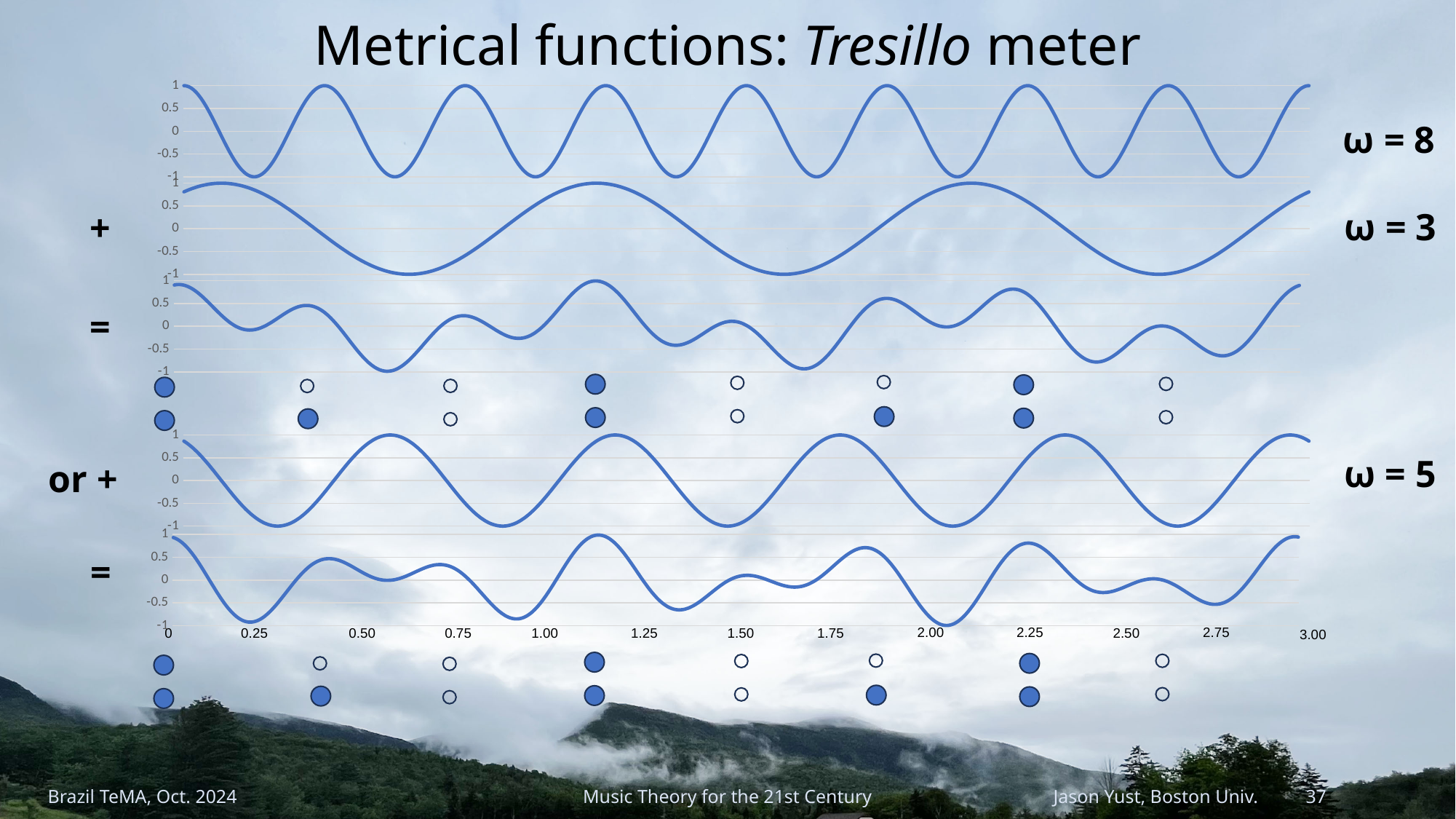
At x = 0.25, which curve is higher: the ω = 8 curve or the ω = 3 curve? ω = 3 What is the label to the right of the topmost chart? ω = 8 What is the largest tick value on the horizontal axis at the bottom of the slide? 3.00 What is the label to the right of the second chart from the top? ω = 3 In the ω = 8 chart, what is the value of the curve at x = 0? 1 In the ω = 3 chart, is the value of the curve at x = 1.00 greater or less than 0.5? greater How many line charts are stacked on the slide? 5 In the ω = 3 chart, is the value of the curve at x = 0.50 greater or less than 0? less In the ω = 8 chart, does the curve rise or fall between x = 0 and x = 0.25? fall What kind of chart is used for the ω = 8 plot at the top of the slide? line chart What is the highest value shown on the vertical axis of the ω = 8 chart? 1 What is the lowest value shown on the vertical axis of the ω = 5 chart? -1